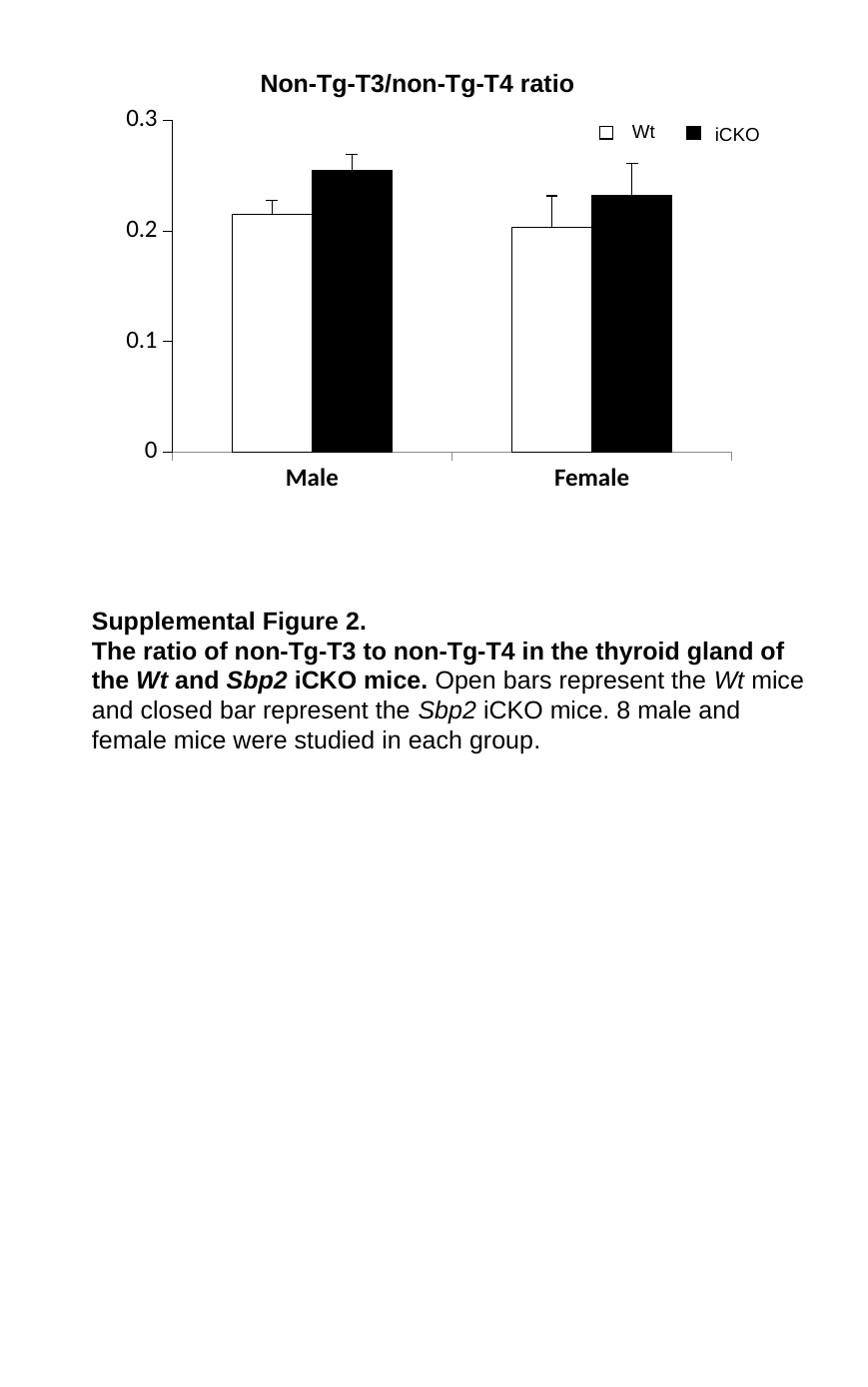
How many categories are shown on the x axis? 2 Which bar is the highest in the chart? Male iCKO How many series does the legend list? 2 Which category has the higher iCKO bar, Male or Female? Male Is the Wt value for Female greater or less than 0.1? greater Which series is represented by the open (white) bars? Wt For Female mice, which is larger, the Wt bar or the iCKO bar? iCKO For Male mice, which is larger, the Wt bar or the iCKO bar? iCKO Is the iCKO value for Male greater or less than 0.2? greater Is the iCKO value for Male greater or less than 0.3? less What is the title of the chart? Non-Tg-T3/non-Tg-T4 ratio What type of chart is shown on the slide? bar chart